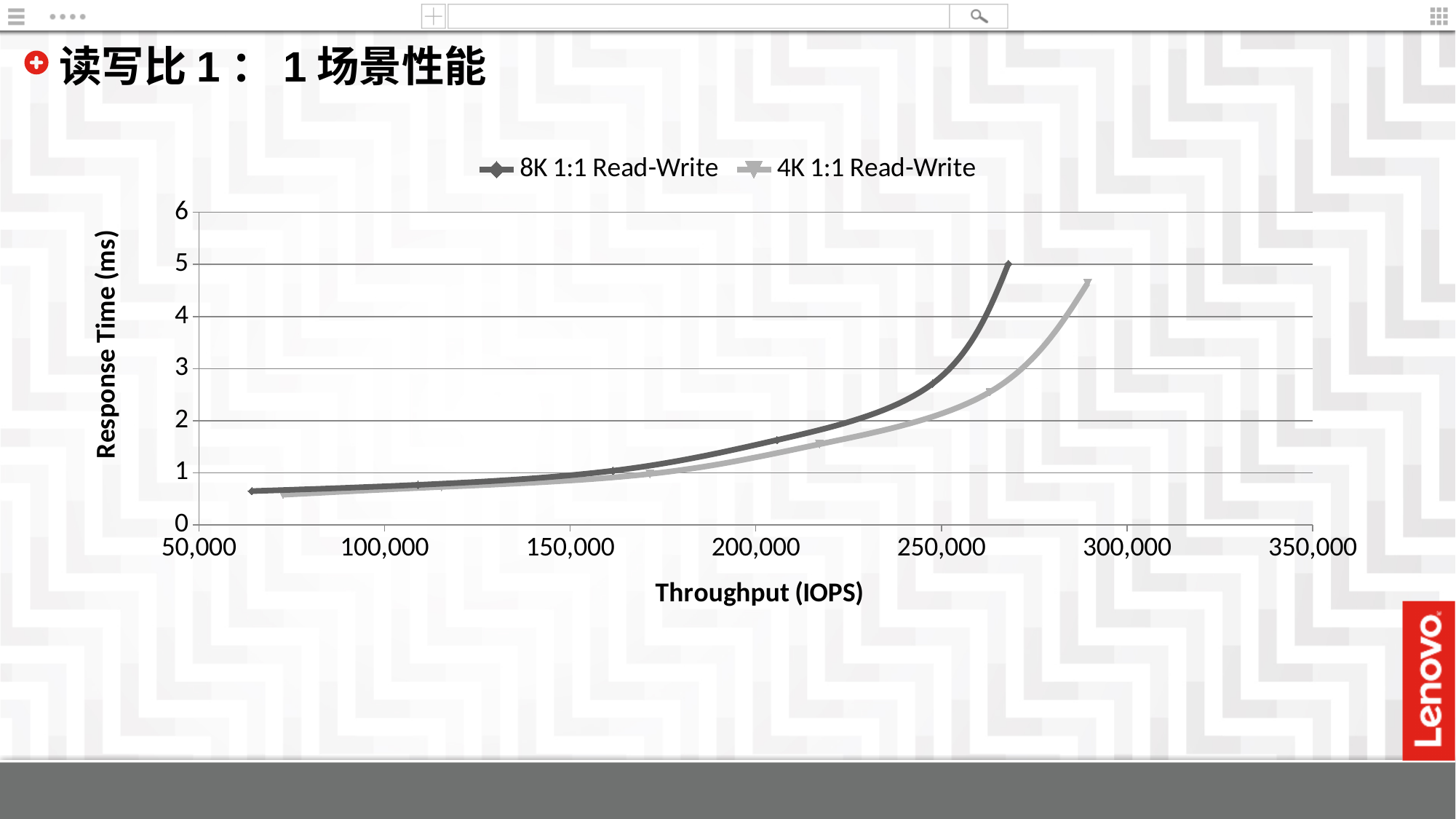
At a throughput of 250,000 IOPS, which series has the higher response time, 8K 1:1 Read-Write or 4K 1:1 Read-Write? 8K 1:1 Read-Write Is the highest response time reached by the 4K 1:1 Read-Write series greater or less than 5? less What is the label of the y axis? Response Time (ms) Is the response time of the 8K 1:1 Read-Write series at 200,000 IOPS greater or less than 2? less How many series does the legend list? 2 Is the maximum throughput reached by the 4K 1:1 Read-Write series greater or less than 250,000? greater What kind of chart is shown on the slide? line chart As throughput increases along the x axis, does the response time rise or fall? rise Which series reaches the higher maximum throughput? 4K 1:1 Read-Write What are the two series named in the legend? 8K 1:1 Read-Write and 4K 1:1 Read-Write